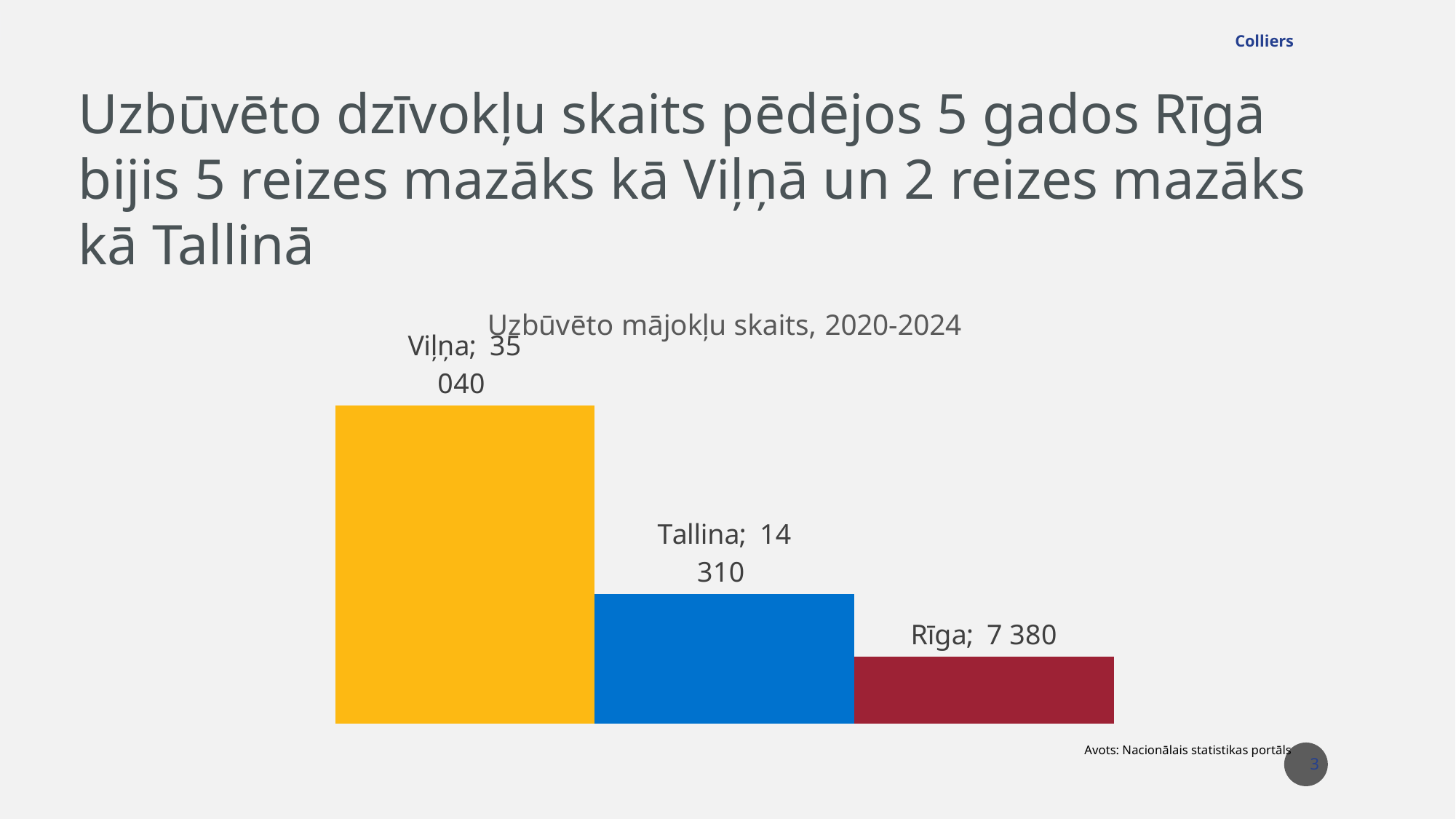
What is the value for Viļņa? 35 040 Which is larger, the value for Tallina or the value for Rīga? Tallina What kind of chart is shown on the slide? bar chart What is the difference between the values for Viļņa and Tallina? 20 730 Which city has the highest value? Viļņa What is the title of the chart? Uzbūvēto mājokļu skaits, 2020-2024 How many cities are shown in the chart? 3 What colour is the bar for Rīga? dark red What is the value for Tallina? 14 310 What is the value for Rīga? 7 380 What is the difference between the values for Tallina and Rīga? 6 930 Which city has the lowest value? Rīga